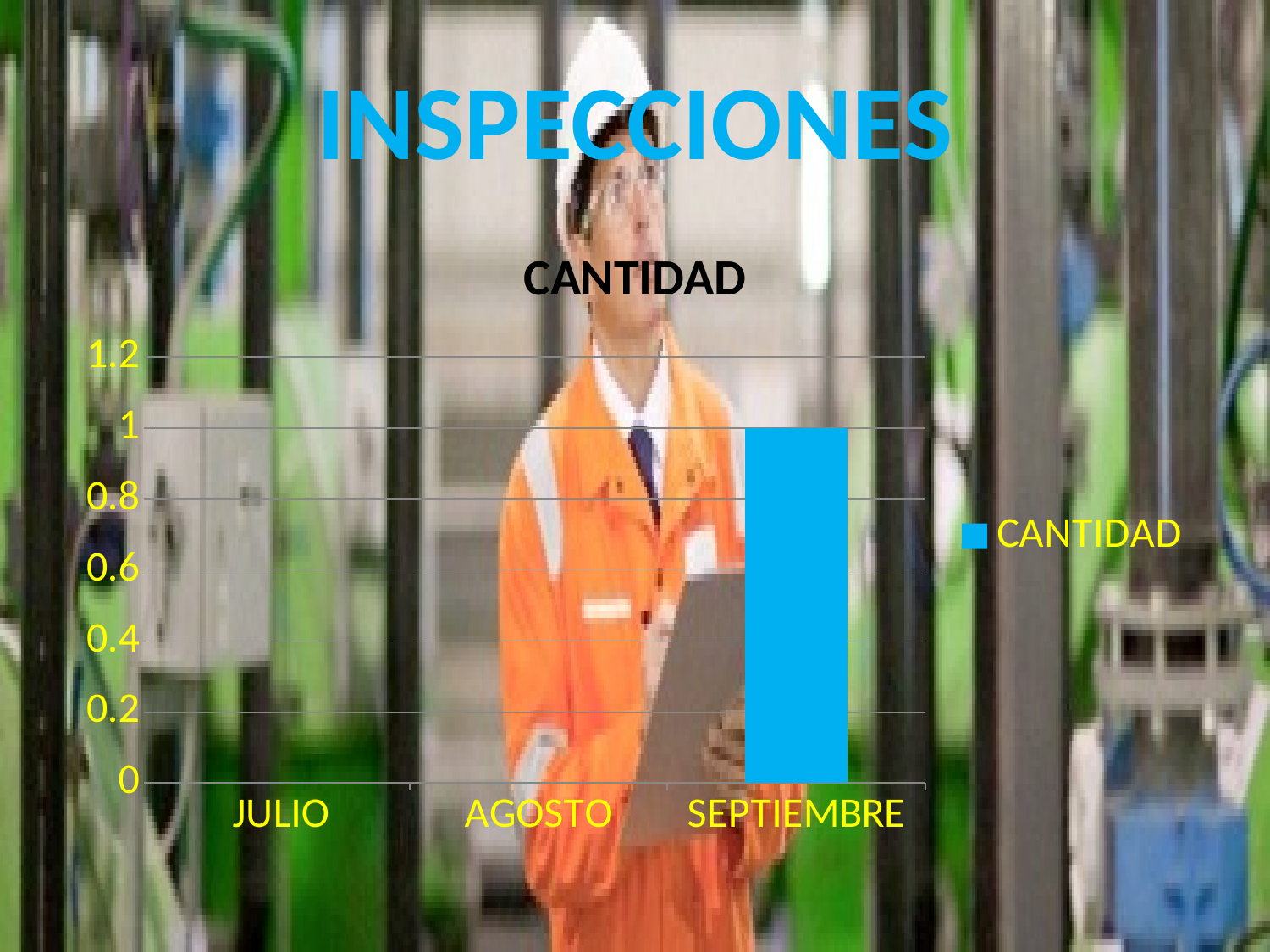
What is the value for SEPTIEMBRE in the chart? 1 Is the value for AGOSTO greater or less than 0.2? less Do the values rise or fall from JULIO to SEPTIEMBRE? rise How many series does the chart legend list? 1 How many categories are shown on the x axis of the chart? 3 Which category has the highest value in the chart? SEPTIEMBRE What type of chart is shown on the slide? bar chart Is the value for JULIO greater or less than 0.2? less Is the value for SEPTIEMBRE greater or less than 0.8? greater Which is larger, the value for SEPTIEMBRE or the value for JULIO? SEPTIEMBRE What is the name of the series shown in the chart legend? CANTIDAD What is the title of the chart? CANTIDAD